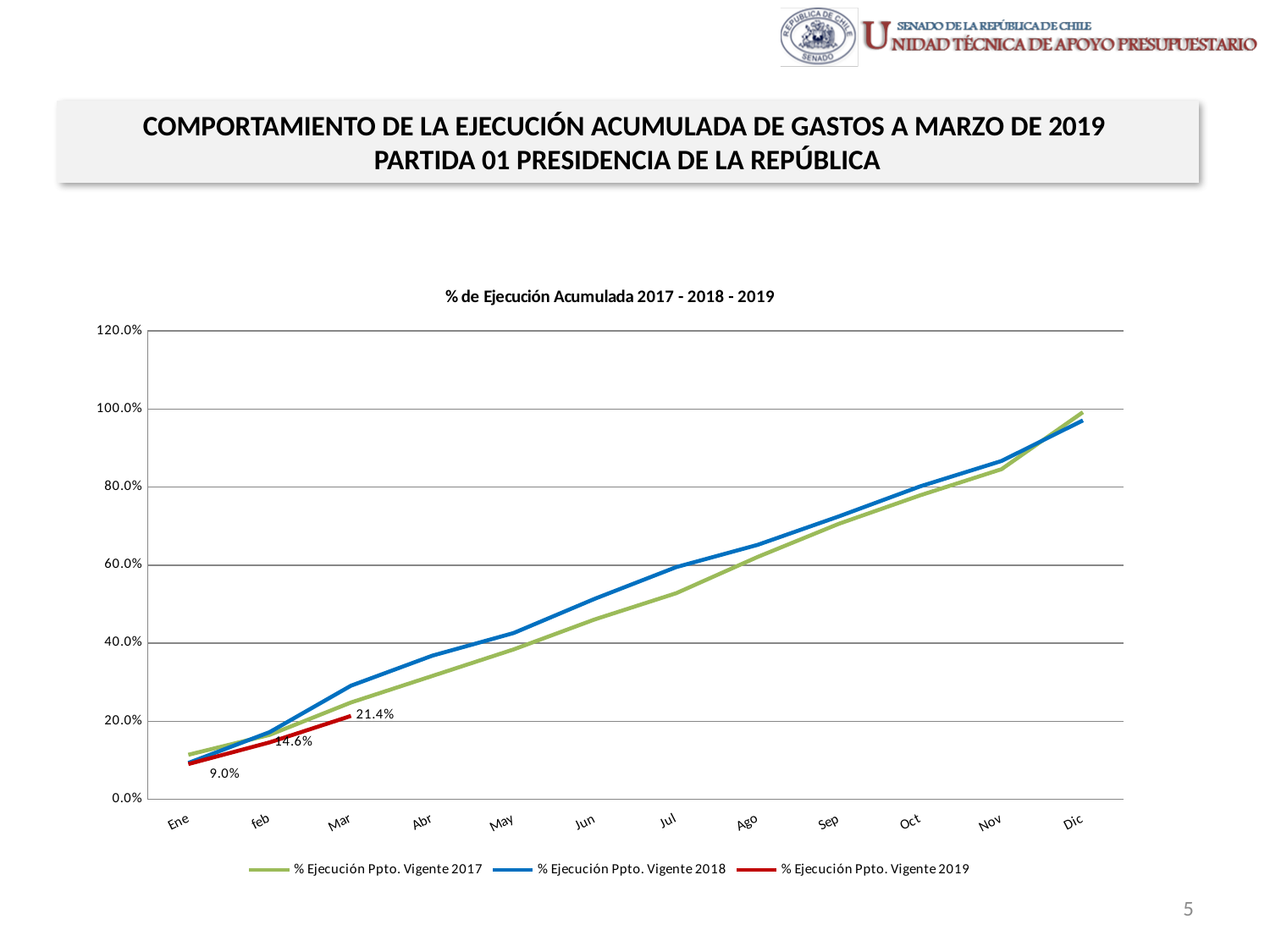
What is the difference between the 2019 values for Mar and Ene? 12.4% How many series does the legend list? 3 Do the values of the 2018 series rise or fall from Ene to Dic? rise What is the title of the chart? % de Ejecución Acumulada 2017 - 2018 - 2019 What is the value of % Ejecución Ppto. Vigente 2019 for Mar? 21.4% What is the value of % Ejecución Ppto. Vigente 2019 for Ene? 9.0% Which month has the highest value for the 2019 series? Mar What kind of chart is shown on the slide? line chart In Jul, which series has the larger value, 2017 or 2018? 2018 What is the value of % Ejecución Ppto. Vigente 2019 for feb? 14.6% Is the value for % Ejecución Ppto. Vigente 2018 in Dic greater or less than 80.0%? greater How many months are shown along the x axis? 12